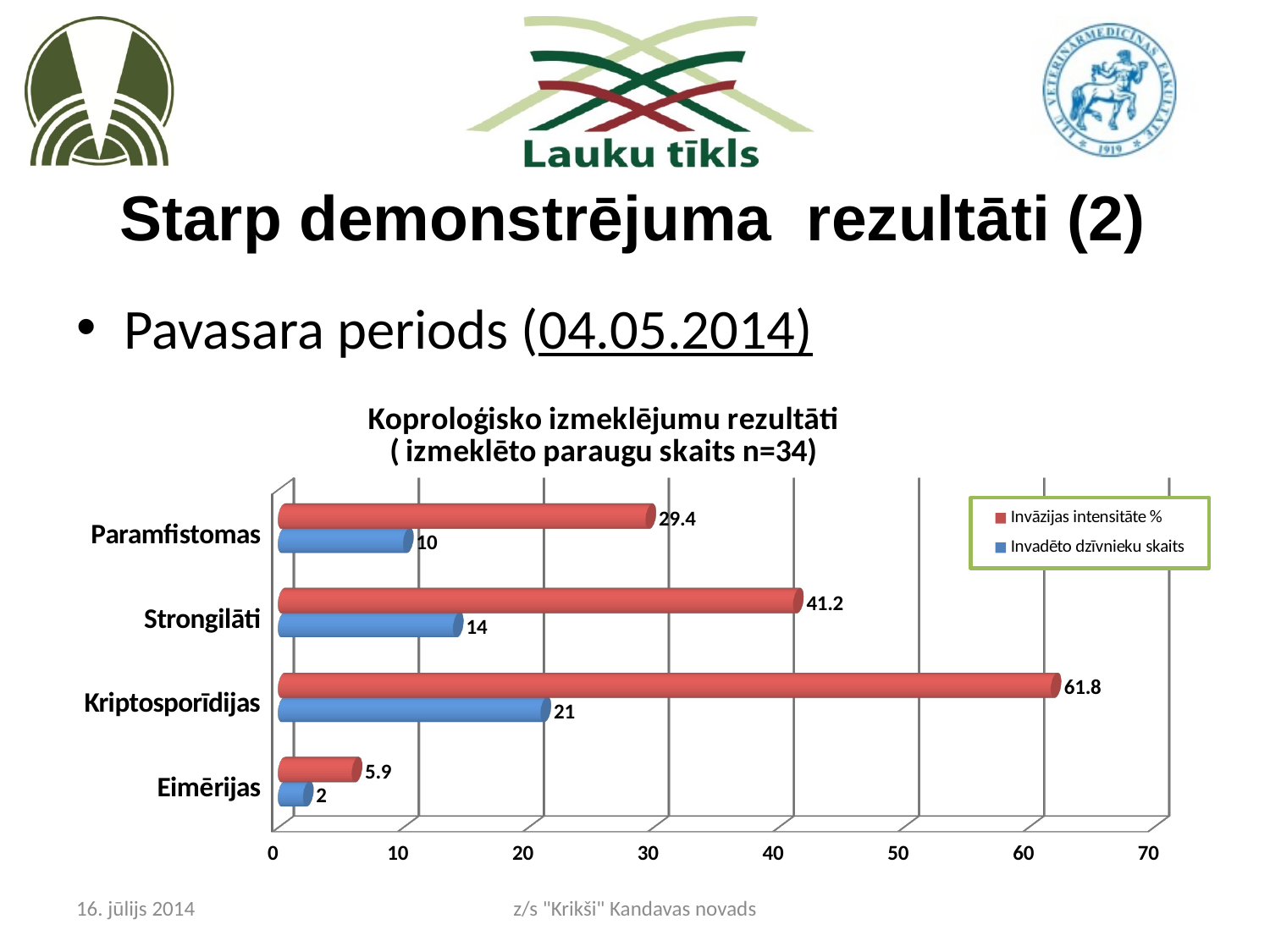
What is the Invāzijas intensitāte % value for Eimērijas? 5.9 How many series does the legend list? 2 What is the title of the chart? Koproloģisko izmeklējumu rezultāti ( izmeklēto paraugu skaits n=34) How many categories are shown on the chart? 4 Is the Invāzijas intensitāte % value for Strongilāti greater or less than 40? greater Which category has the lowest Invadēto dzīvnieku skaits? Eimērijas Which is larger, the Invadēto dzīvnieku skaits for Paramfistomas or for Strongilāti? Strongilāti What kind of chart is shown on the slide? bar chart What is the difference between the Invāzijas intensitāte % values for Kriptosporīdijas and Strongilāti? 20.6 What is the Invadēto dzīvnieku skaits value for Strongilāti? 14 Which category has the highest Invāzijas intensitāte %? Kriptosporīdijas What is the Invāzijas intensitāte % value for Kriptosporīdijas? 61.8